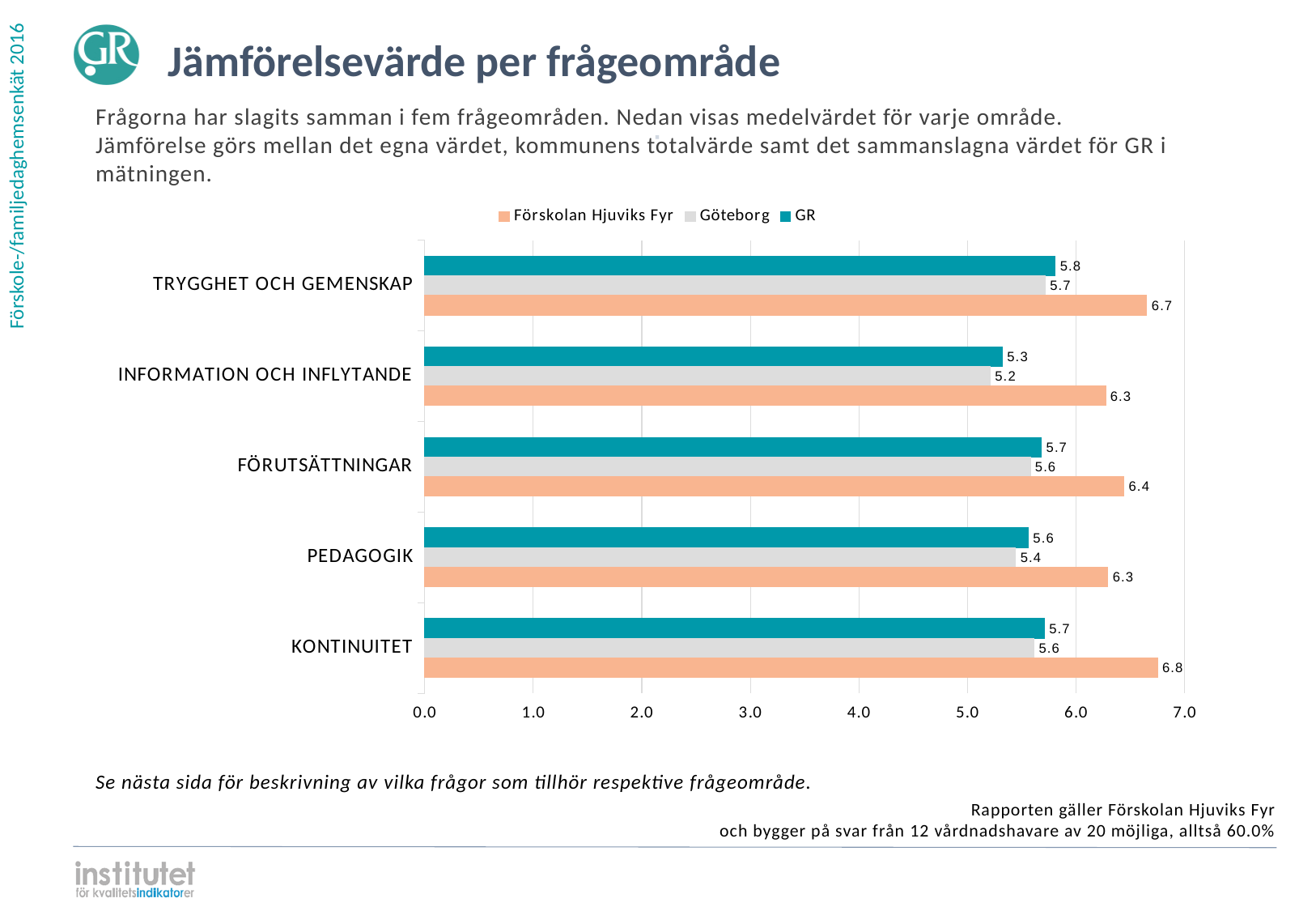
What kind of chart is shown on the slide? bar chart Which category has the highest value for Förskolan Hjuviks Fyr? KONTINUITET What is the value for Göteborg in the INFORMATION OCH INFLYTANDE category? 5.2 Is the value for Göteborg in the PEDAGOGIK category greater or less than 6.0? less Which category has the lowest value for GR? INFORMATION OCH INFLYTANDE How many series does the legend list? 3 In the FÖRUTSÄTTNINGAR category, which is larger: the value for Förskolan Hjuviks Fyr or the value for GR? Förskolan Hjuviks Fyr What is the value for Förskolan Hjuviks Fyr in the KONTINUITET category? 6.8 What is the difference between the Förskolan Hjuviks Fyr value and the Göteborg value in the TRYGGHET OCH GEMENSKAP category? 1.0 How many categories are shown on the chart? 5 Which series is shown in orange in the legend? Förskolan Hjuviks Fyr What is the value for GR in the PEDAGOGIK category? 5.6